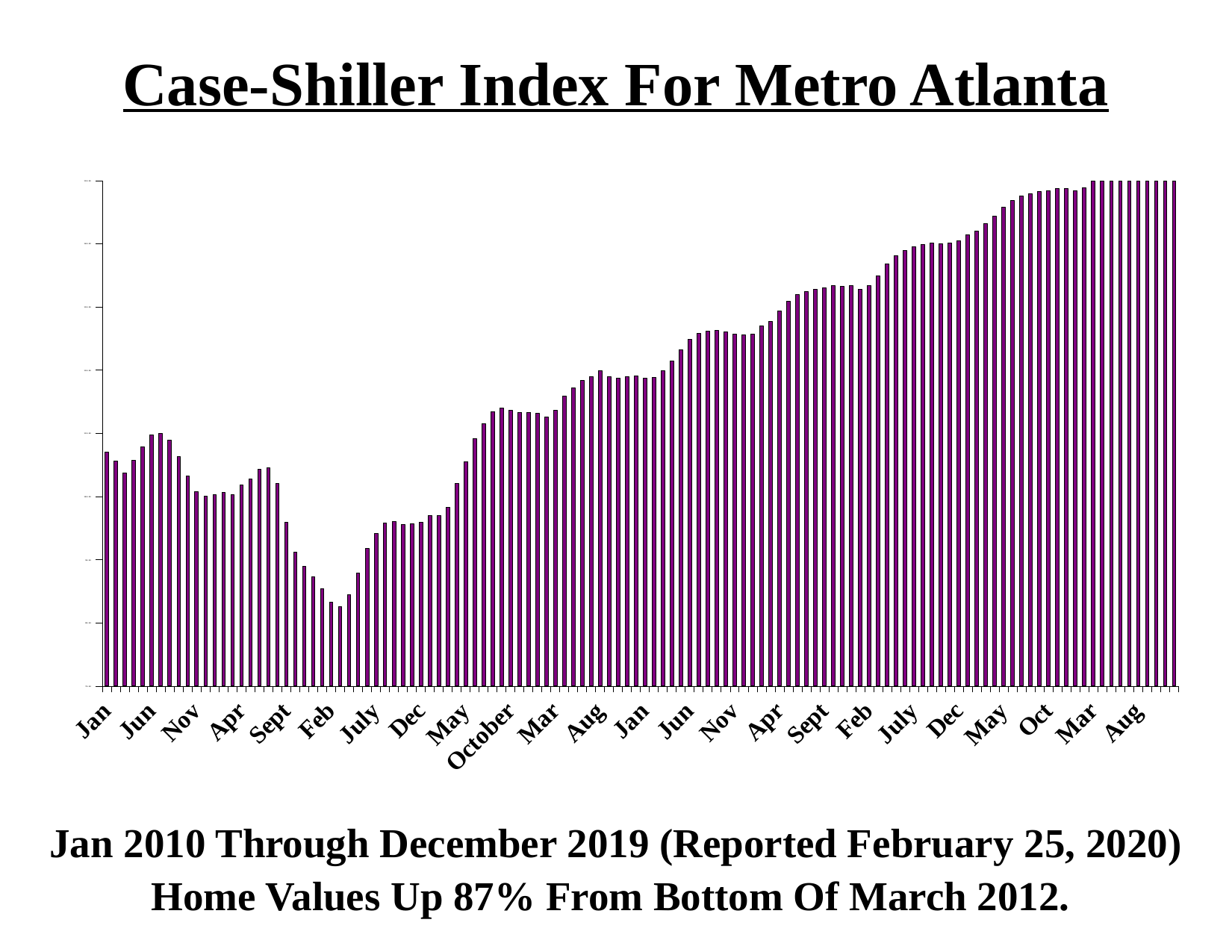
Do the bars generally rise or fall from the 2012 low to the end of the series in 2019? Rise What time period does the chart cover according to the slide? Jan 2010 through December 2019 Do the bars rise or fall between the first 'Sept' label and the first 'Feb' label? Fall Which is higher, the bar at the first 'Jan' label or the bar at the last 'Aug' label? The last 'Aug' label By what percentage does the slide say home values are up from the bottom of March 2012? 87% Which is lower, the bar at the first 'Feb' label or the bar at the first 'Dec' label? The first 'Feb' label What is the title of the chart? Case-Shiller Index For Metro Atlanta How many month labels are printed along the x axis? 24 What colour are the bars in the chart? Purple What kind of chart is shown on the slide? Bar chart Which is higher, the bar at the first 'Jun' label or the bar at the first 'Nov' label? The first 'Jun' label According to the slide, in which month did the index reach its bottom (lowest value)? March 2012